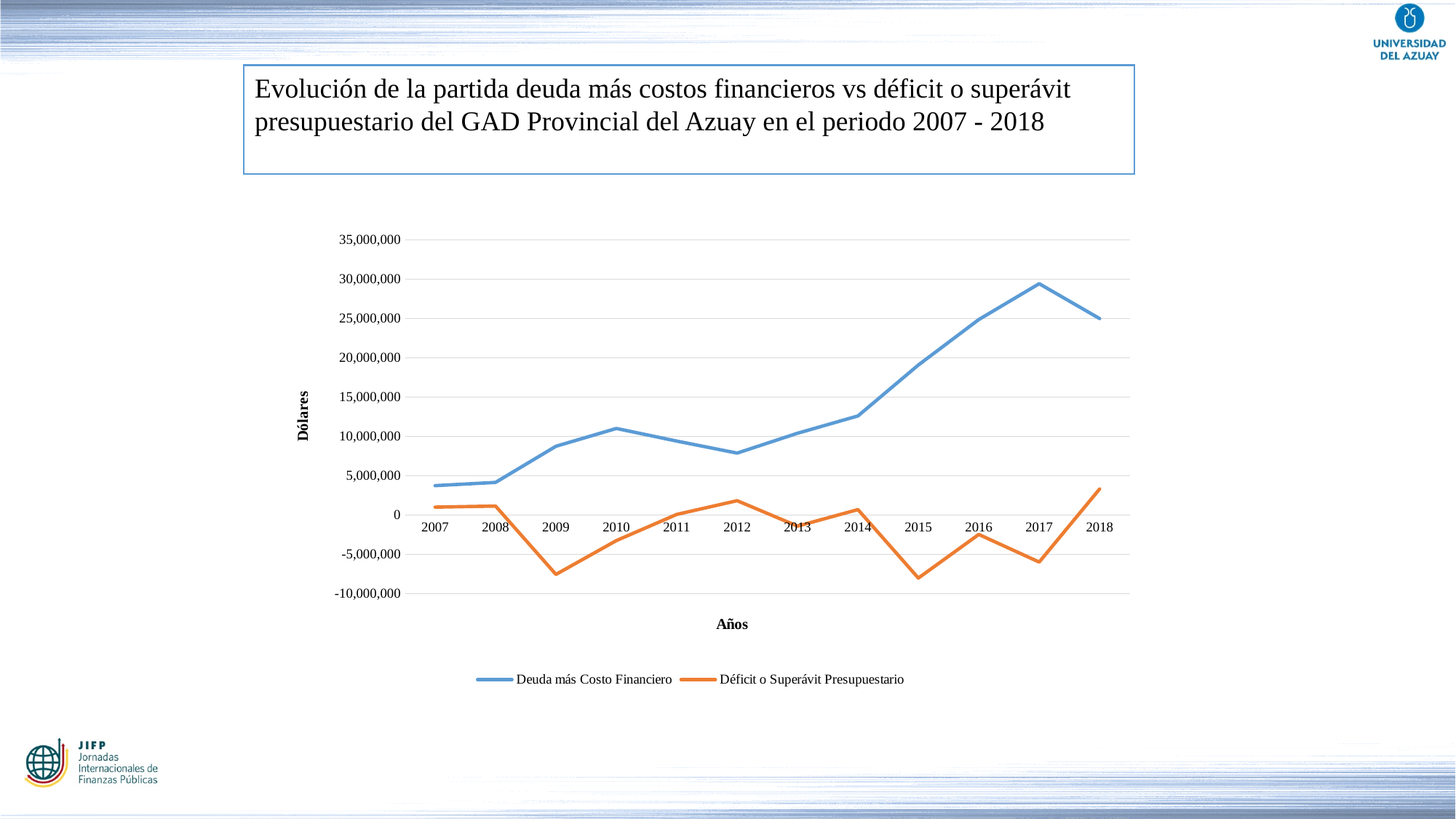
Is the value for Deuda más Costo Financiero in 2017 greater or less than 25,000,000? greater In which year is the Deuda más Costo Financiero series at its lowest value? 2007 Does the Deuda más Costo Financiero series rise or fall between 2014 and 2017? rise Is the value for Déficit o Superávit Presupuestario in 2015 greater or less than -5,000,000? less Is the value for Déficit o Superávit Presupuestario in 2018 greater or less than 0? greater How many series does the legend list? 2 What is the label of the vertical axis? Dólares How many years are plotted along the x axis? 12 In which year does the Deuda más Costo Financiero series reach its highest value? 2017 Which is larger, the Deuda más Costo Financiero value in 2017 or in 2018? 2017 What kind of chart is shown on the slide? line chart